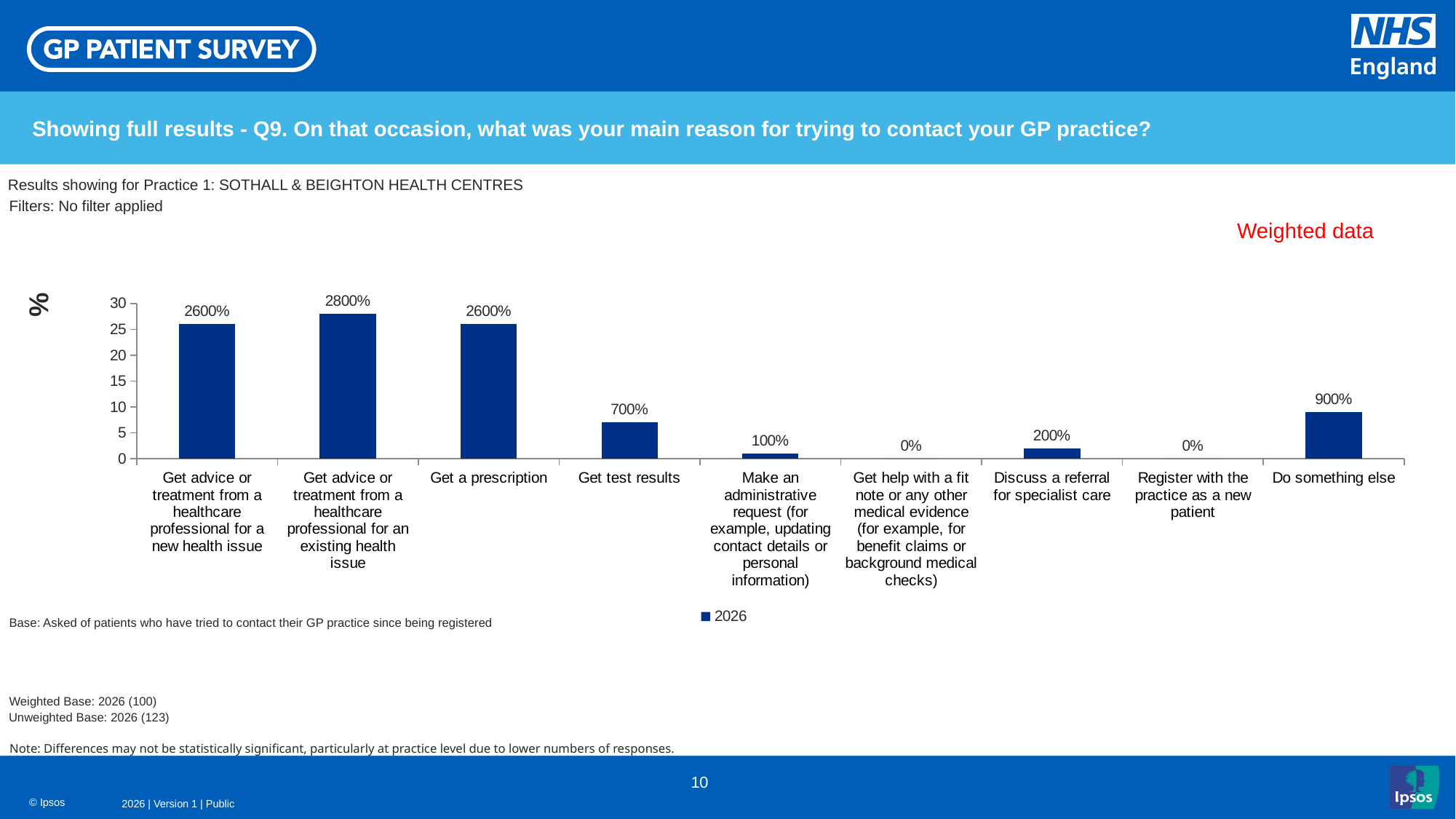
How many categories are shown on the x axis of the chart? 9 What is the data label shown for 'Get test results'? 700% Which category has the highest value in the chart? Get advice or treatment from a healthcare professional for an existing health issue What is the data label shown for 'Do something else'? 900% Which is larger: the value for 'Get test results' or the value for 'Do something else'? Do something else Is the bar for 'Get a prescription' greater or less than 20 on the y axis? greater What series name is shown in the chart legend? 2026 What is the data label shown for 'Discuss a referral for specialist care'? 200% What is the difference between the data labels for 'Get test results' and 'Discuss a referral for specialist care'? 500% What is the data label shown for 'Get a prescription'? 2600% How many series does the chart legend list? 1 What kind of chart is shown on the slide? bar chart